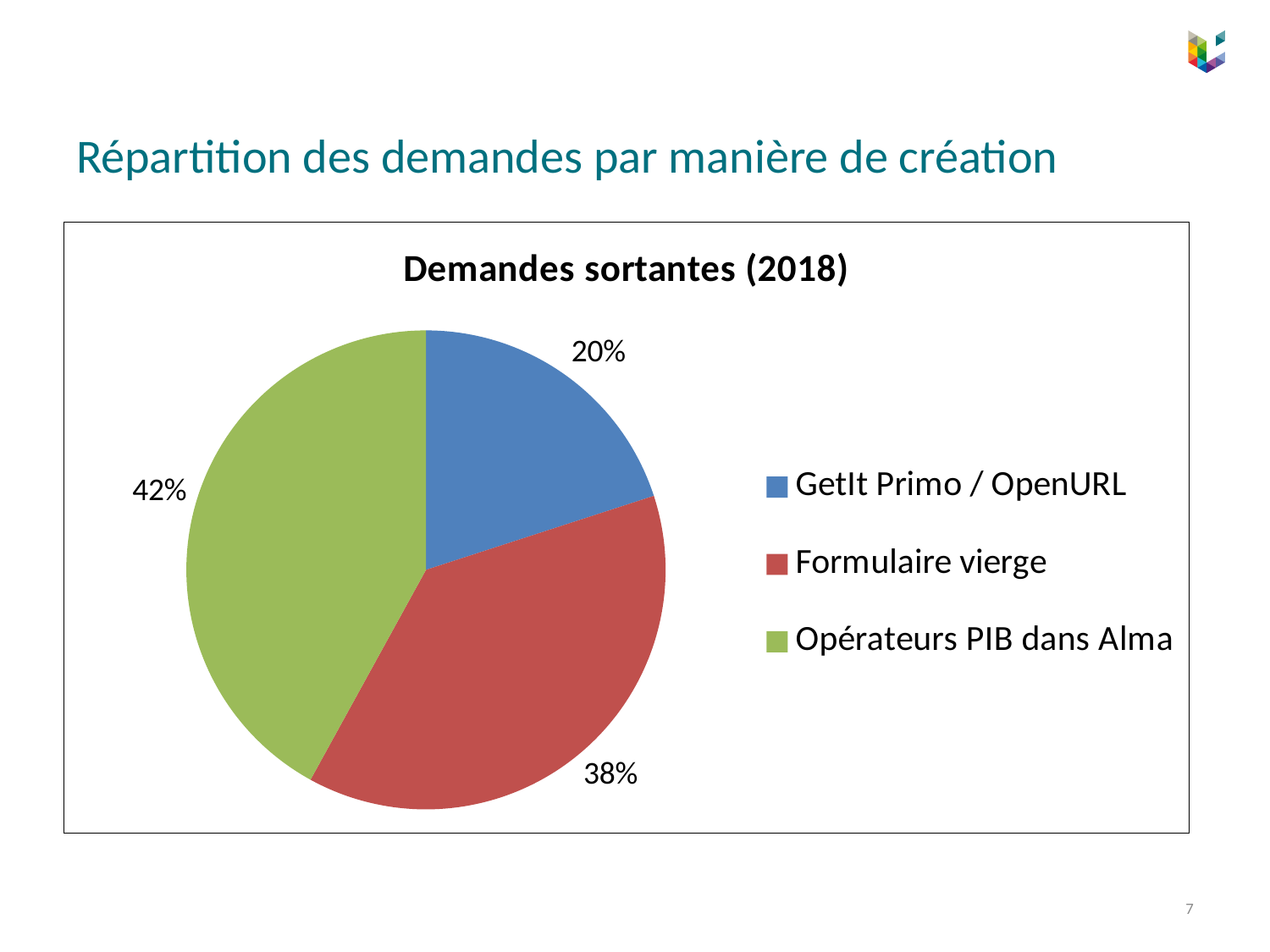
What share of the pie does GetIt Primo / OpenURL represent? 20% Which category has the smallest slice of the pie? GetIt Primo / OpenURL What is the difference in percentage points between Opérateurs PIB dans Alma and GetIt Primo / OpenURL? 22 percentage points What is the difference in percentage points between Formulaire vierge and GetIt Primo / OpenURL? 18 percentage points Which colour represents Formulaire vierge in the chart? Red How many categories does the pie chart show? 3 Which is larger, the share for Formulaire vierge or the share for GetIt Primo / OpenURL? Formulaire vierge Which category has the largest slice of the pie? Opérateurs PIB dans Alma What share of the pie does Opérateurs PIB dans Alma represent? 42% What share of the pie does Formulaire vierge represent? 38% What kind of chart is shown on the slide? Pie chart What is the title of the chart? Demandes sortantes (2018)